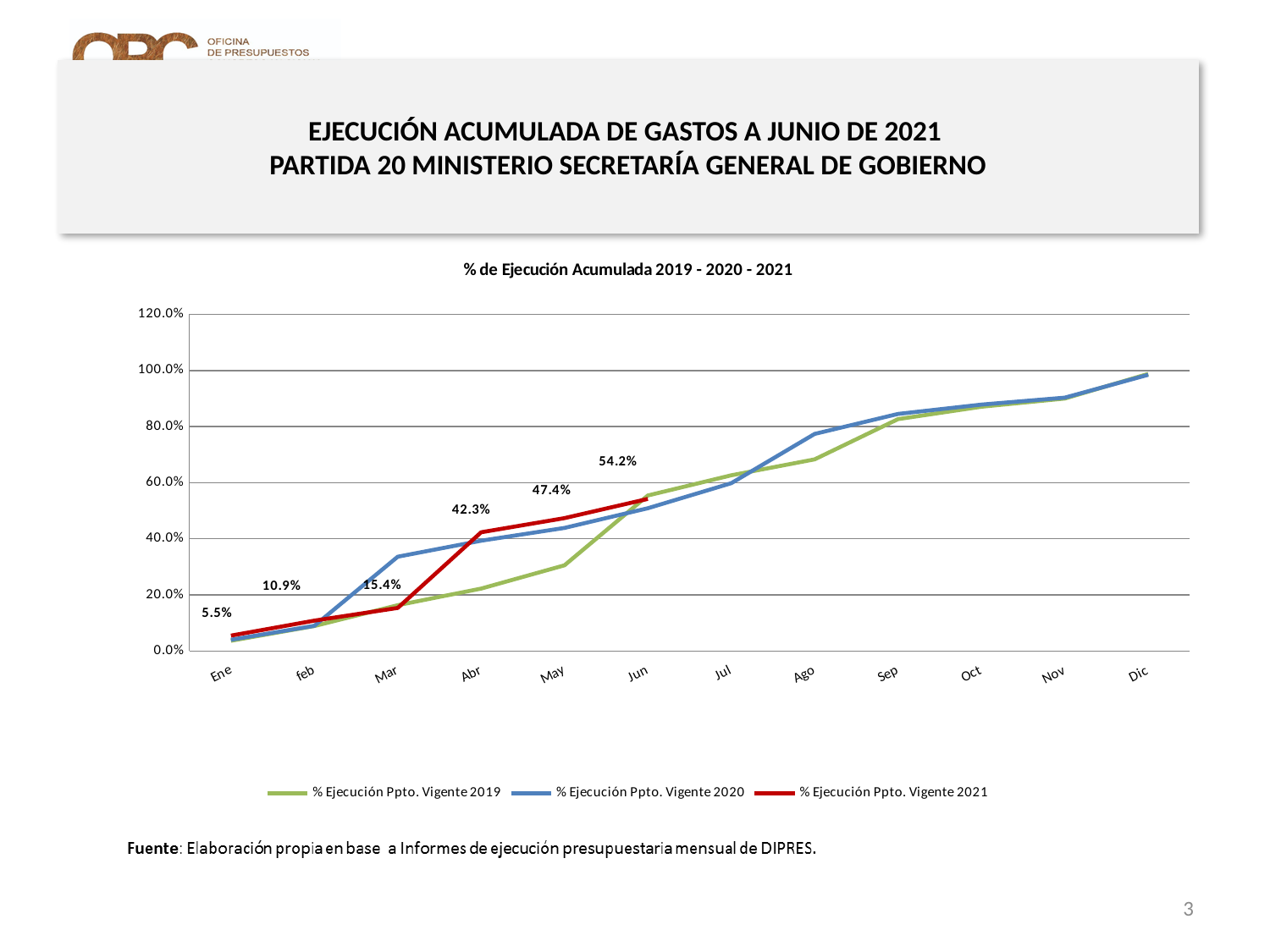
How many series does the legend list? 3 What is the value of % Ejecución Ppto. Vigente 2021 for Jun? 54.2% What is the value of % Ejecución Ppto. Vigente 2021 for Ene? 5.5% Which month has the highest labelled value for % Ejecución Ppto. Vigente 2021? Jun What colour is the line for % Ejecución Ppto. Vigente 2021? Red In Mar, which series is higher: % Ejecución Ppto. Vigente 2020 or % Ejecución Ppto. Vigente 2019? % Ejecución Ppto. Vigente 2020 By how many percentage points did % Ejecución Ppto. Vigente 2021 increase from Mar to Abr? 26.9 percentage points By how many percentage points did % Ejecución Ppto. Vigente 2021 increase from May to Jun? 6.8 percentage points Is the value of % Ejecución Ppto. Vigente 2019 for May greater or less than 40.0%? less Is the value of % Ejecución Ppto. Vigente 2020 for Ago greater or less than 60.0%? greater What kind of chart is shown on the slide? Line chart What is the value of % Ejecución Ppto. Vigente 2021 for Abr? 42.3%